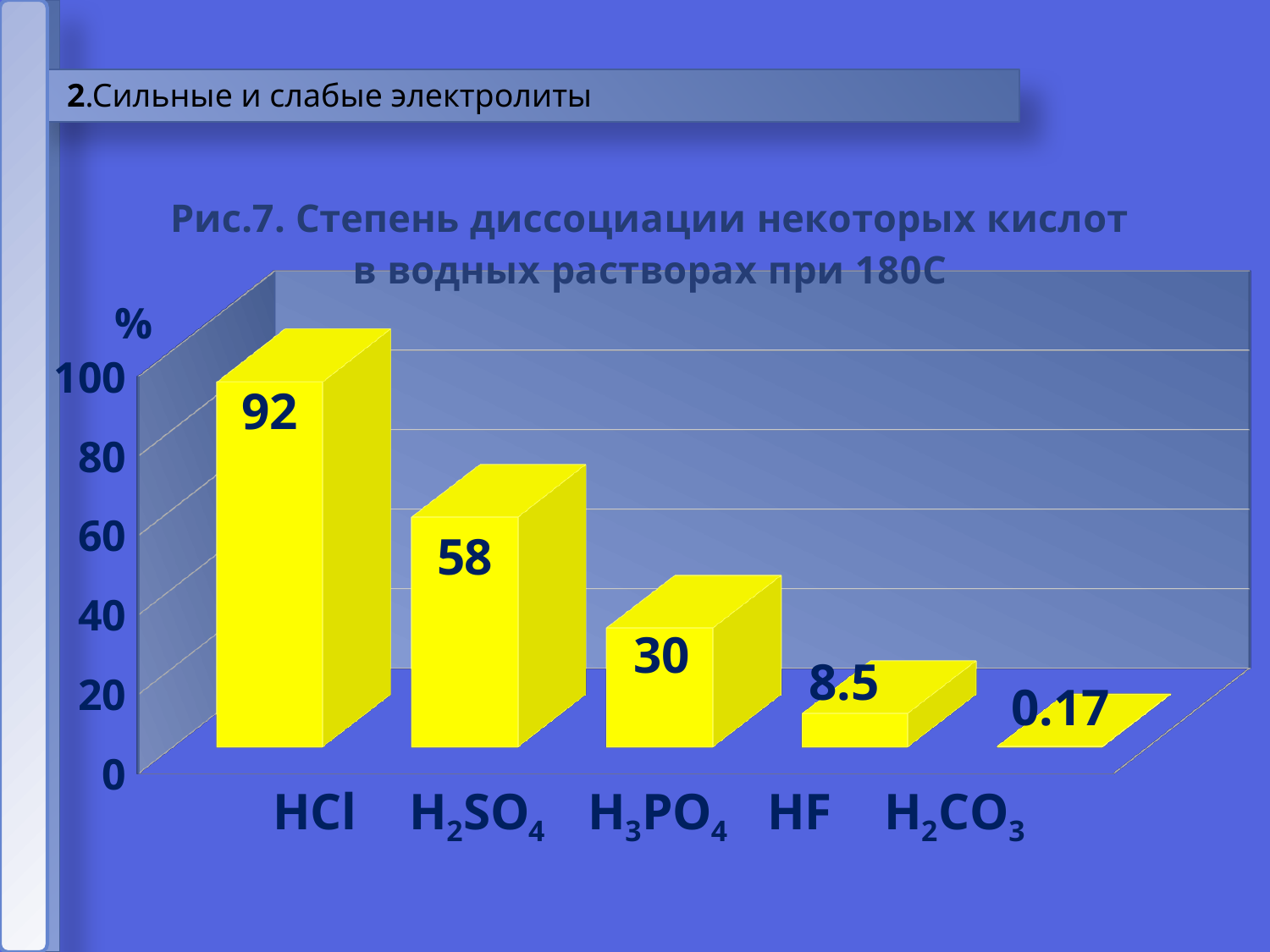
What value is shown for H2CO3? 0.17 What is the difference between the values for HCl and H2SO4? 34 What is the degree of dissociation shown for HCl? 92 What value is shown for HF? 8.5 What kind of chart is shown on the slide? Bar chart What value is shown for H3PO4? 30 How many acids are shown in the chart? 5 What value is shown for H2SO4? 58 Do the values rise or fall from left to right along the x axis? Fall Which acid has the highest degree of dissociation? HCl Which acid has the lowest degree of dissociation? H2CO3 Which has a larger value, H3PO4 or HF? H3PO4